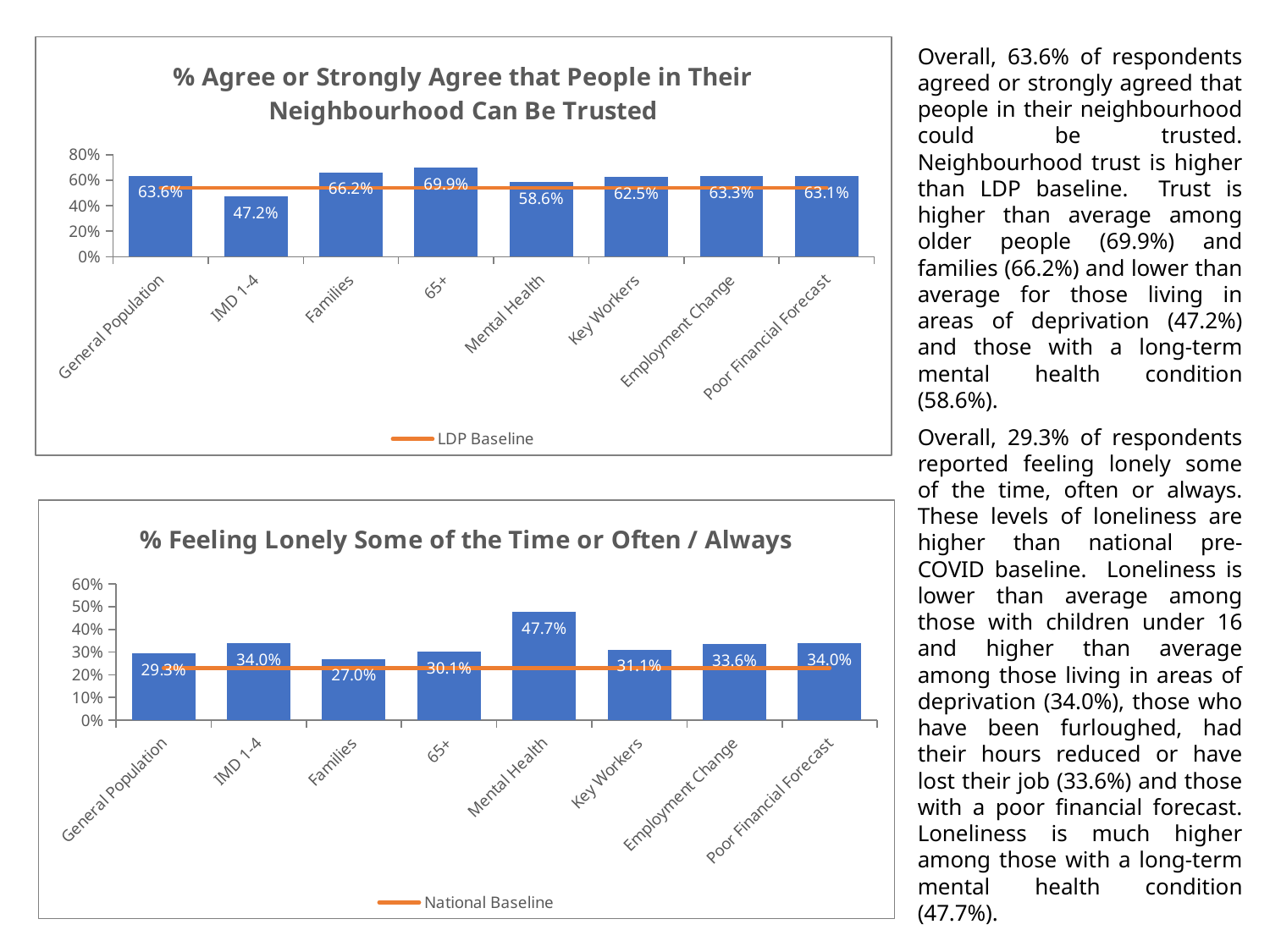
In the top chart, which category has the highest value? 65+ In the bottom chart, what is the value for Mental Health? 47.7% In the bottom chart, which category has the lowest value? Families In the bottom chart, what is the difference between the values for Mental Health and General Population? 18.4% In the top chart, what is the value for IMD 1-4? 47.2% In the top chart, is the value for Families greater or less than 60%? greater In the bottom chart, which is larger, the value for Employment Change or the value for General Population? Employment Change In the top chart, which category has the lowest value? IMD 1-4 What kind of chart is the top chart? Combination bar and line chart (bars with an LDP Baseline line) How many categories are shown on the x axis of the bottom chart? 8 What entry does the legend of the bottom chart list? National Baseline In the top chart, what is the difference between the values for 65+ and Mental Health? 11.3%